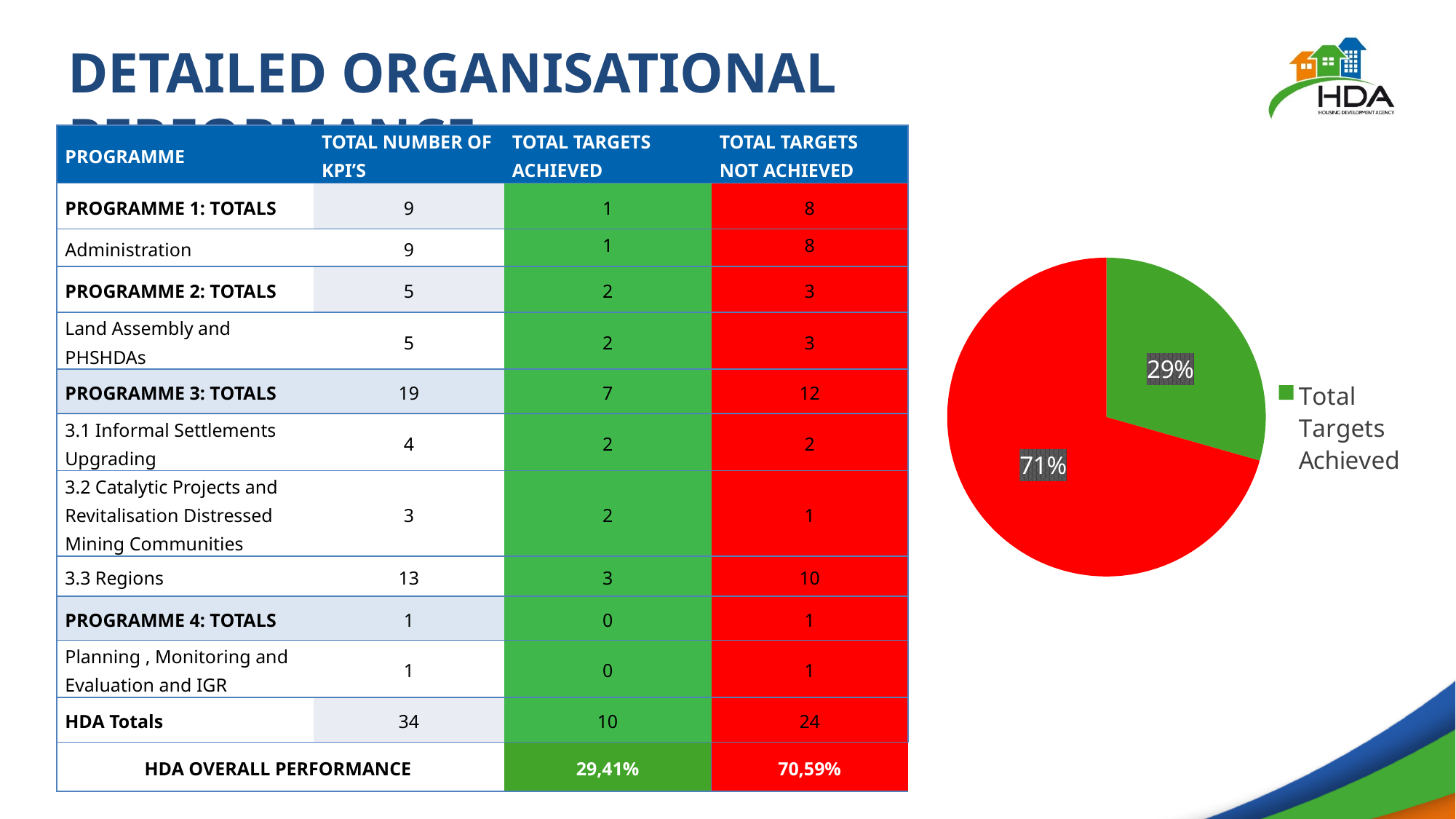
Which slice of the pie chart is the largest? the red slice (71%) How many slices does the pie chart have? 2 What is the value shown on the green slice of the pie chart? 29% What share of the pie chart does the red slice represent? 71% Which slice of the pie chart is the smallest? the green slice (29%) Which is larger in the pie chart, the green slice or the red slice? the red slice What colour is the slice labelled 29% in the pie chart? green What share of the pie chart does the green slice represent? 29% What legend entry is shown next to the pie chart? Total Targets Achieved What is the difference between the red slice and the green slice in the pie chart? 42% What kind of chart is shown on the slide? pie chart What is the value shown on the red slice of the pie chart? 71%